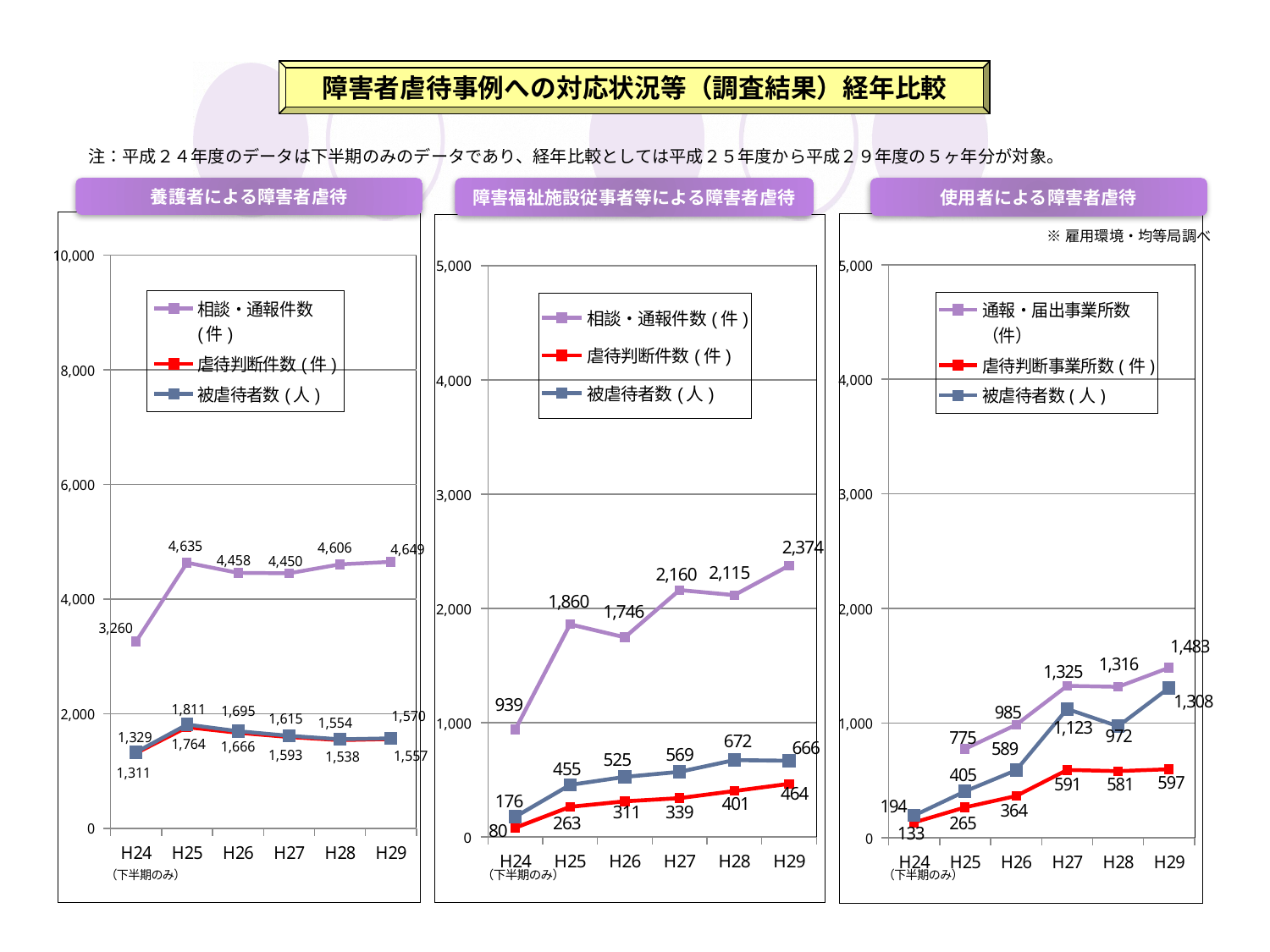
In the 使用者による障害者虐待 chart, what is the 被虐待者数 value for H29? 1,308 In the 障害福祉施設従事者等による障害者虐待 chart, what is the 虐待判断件数 value for H29? 464 What type of chart is the 使用者による障害者虐待 chart? line chart In the 障害福祉施設従事者等による障害者虐待 chart, is the 被虐待者数 value for H28 larger or smaller than the value for H29? larger In the 障害福祉施設従事者等による障害者虐待 chart, which year has the highest 相談・通報件数? H29 In the 養護者による障害者虐待 chart, what is the difference between the 被虐待者数 and 虐待判断件数 values for H25? 47 In the 養護者による障害者虐待 chart, how many series does the legend list? 3 In the 養護者による障害者虐待 chart, which year has the lowest 相談・通報件数? H24 How many year categories are shown on the x axis of the 養護者による障害者虐待 chart? 6 In the 使用者による障害者虐待 chart, which year has the highest 虐待判断事業所数? H29 In the 障害福祉施設従事者等による障害者虐待 chart, what is the difference between the 相談・通報件数 values for H29 and H24? 1,435 In the 養護者による障害者虐待 chart, what is the 相談・通報件数 value for H25? 4,635